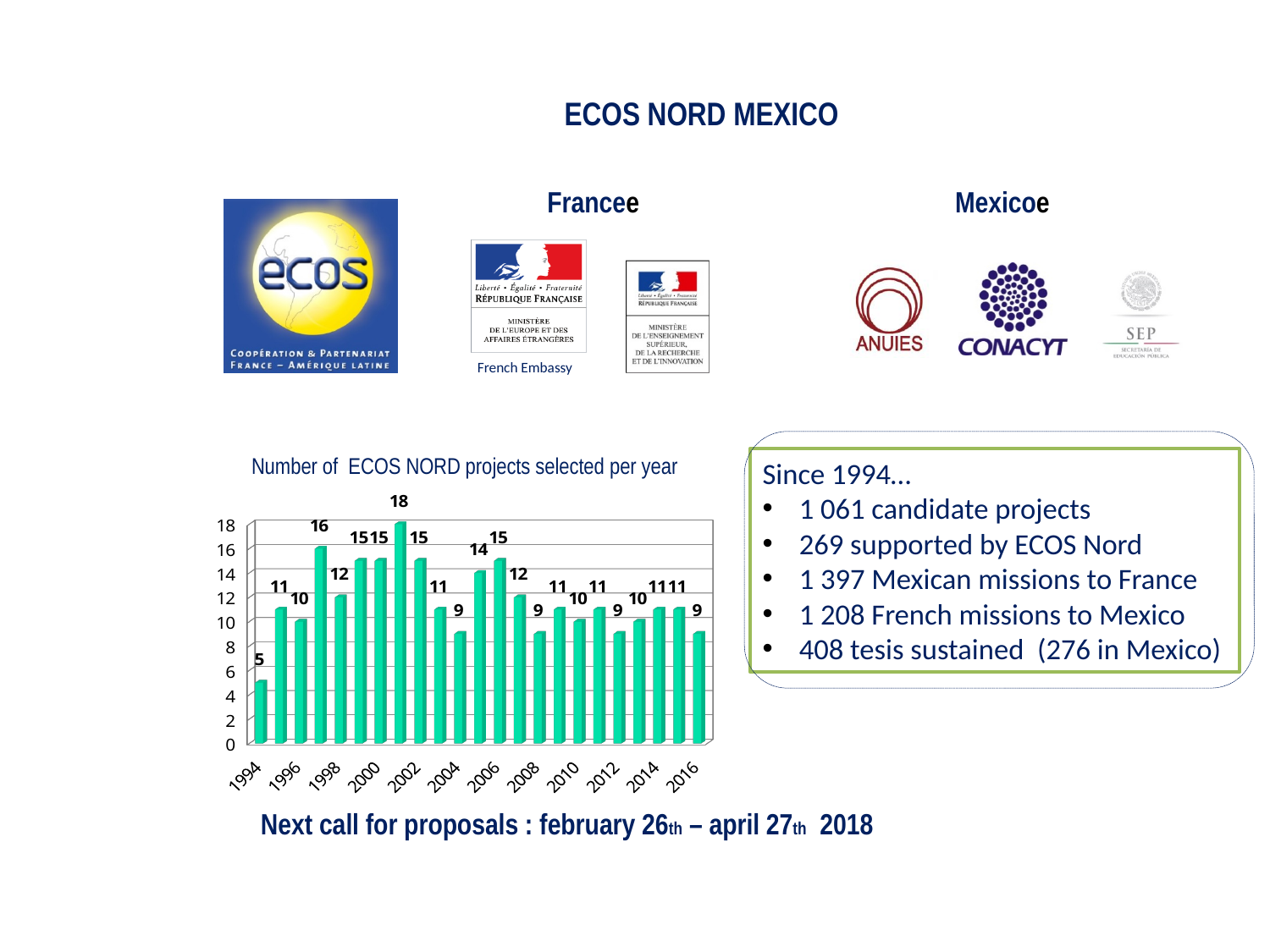
How many ECOS NORD projects were selected in 2014? 11 What kind of chart is used to show the number of ECOS NORD projects selected per year? bar chart What is the title of the chart on the slide? Number of ECOS NORD projects selected per year What is the difference between the number of projects selected in 2000 and in 1994? 10 Which year had more projects selected, 1998 or 2004? 1998 How many ECOS NORD projects were selected in 2016? 9 How many bars (years) are shown in the chart? 23 How many ECOS NORD projects were selected in 1994? 5 How many ECOS NORD projects were selected in 2000? 15 Which year has the lowest number of ECOS NORD projects selected? 1994 What is the difference between the number of projects selected in 2006 and in 2008? 6 What is the highest number of projects selected in a single year shown on the chart? 18